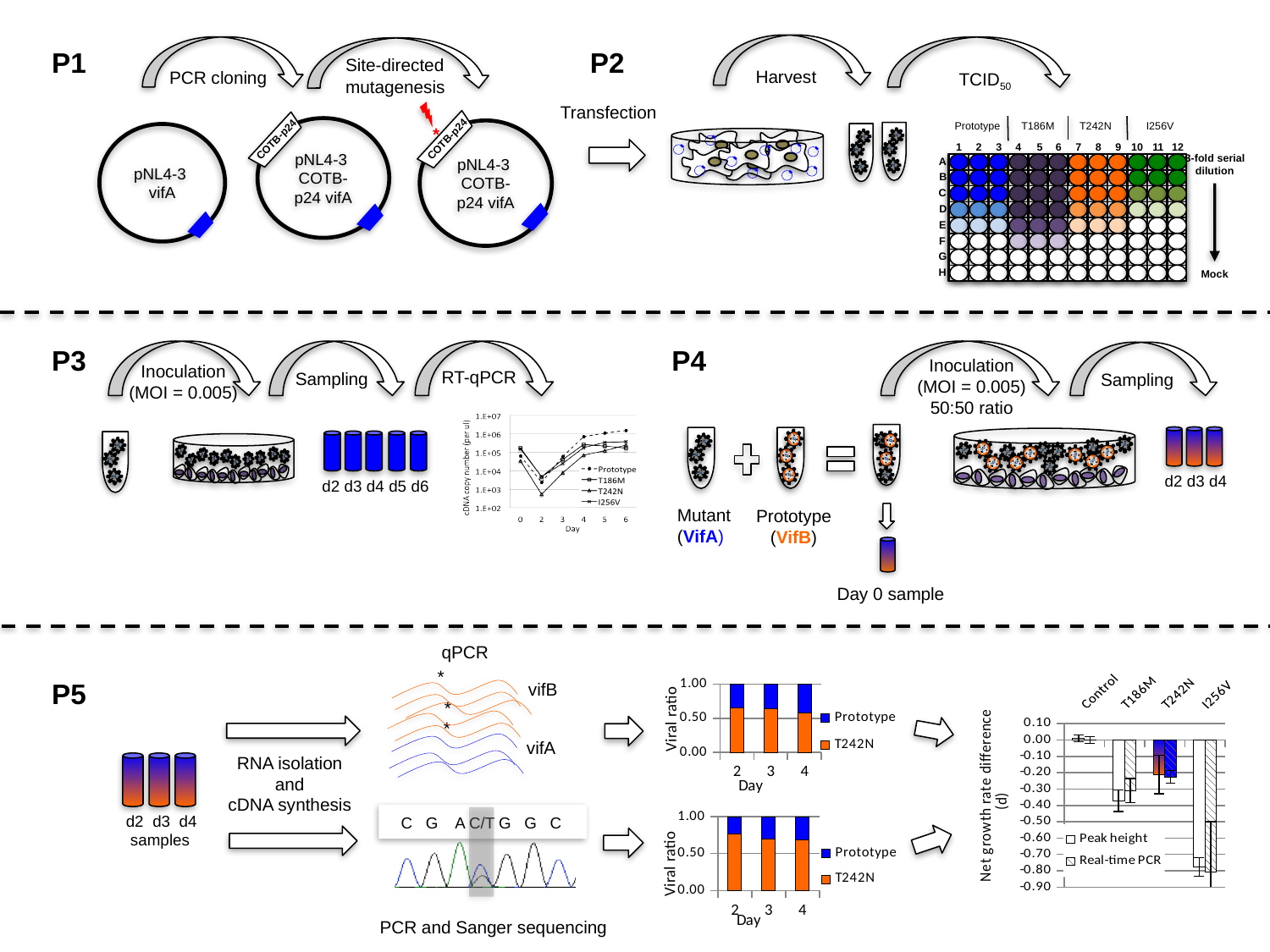
In the Net growth rate difference chart in P5, is the Real-time PCR value for I256V greater or less than -0.50? less What kind of chart is the upper Viral ratio chart in the P5 section? bar chart What kind of chart is shown in the P3 section (cDNA copy number versus Day)? line chart In the P3 line chart (cDNA copy number versus Day), do the values rise or fall between Day 2 and Day 4? rise How many days are shown on the x axis of the lower Viral ratio chart in P5? 3 In the upper Viral ratio chart in P5, is the T242N value at Day 2 greater or less than 0.50? greater How many series does the legend of the upper Viral ratio chart in P5 list? 2 In the Net growth rate difference chart in P5, which category has the lowest (most negative) values? I256V How many series does the legend of the P3 line chart (cDNA copy number versus Day) list? 4 In the Net growth rate difference chart in P5, how many categories are shown on the x axis? 4 In the lower Viral ratio chart in P5, is the T242N value at Day 2 greater or less than 0.50? greater What are the two legend entries of the Net growth rate difference chart in P5? Peak height, Real-time PCR